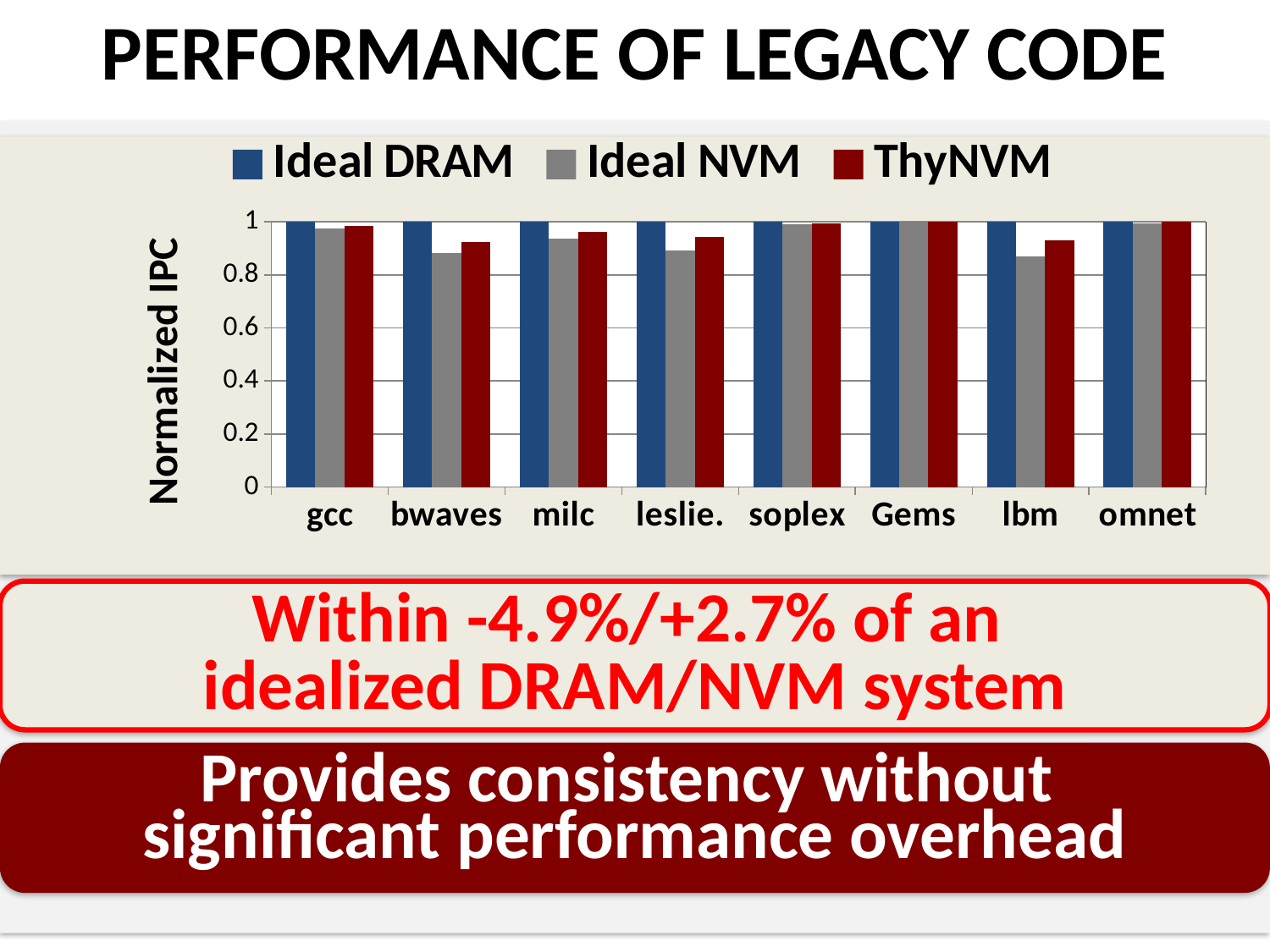
Is the ThyNVM value for bwaves greater or less than 0.8? greater How many series does the legend list? 3 For bwaves, which is larger: the Ideal NVM value or the ThyNVM value? ThyNVM For lbm, which is larger: the Ideal DRAM value or the Ideal NVM value? Ideal DRAM For milc, which is larger: the Ideal NVM value or the ThyNVM value? ThyNVM What is the Normalized IPC value for Ideal DRAM on gcc? 1 What kind of chart is shown on the slide? bar chart What is the label of the y axis? Normalized IPC How many benchmark categories are shown on the x axis? 8 What is the Normalized IPC value for Ideal DRAM on lbm? 1 Which series is shown in gray in the legend? Ideal NVM Is the Ideal NVM value for lbm greater or less than 0.8? greater